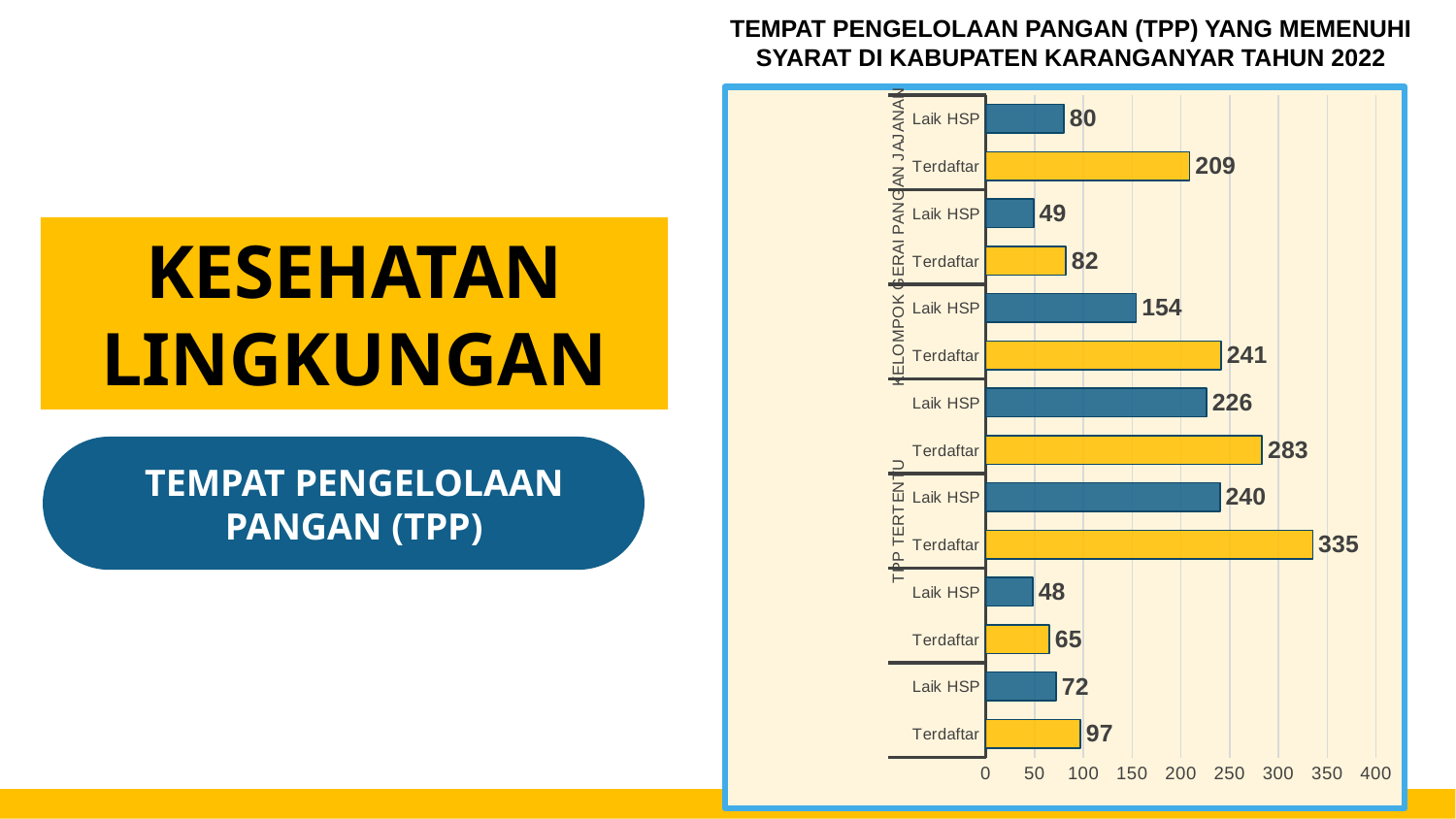
What is the highest value shown on any bar in the chart? 335 Which is larger: the bottom-most Terdaftar bar or the bottom-most Laik HSP bar? Terdaftar What kind of chart is shown on the slide? bar chart What is the difference between the topmost Terdaftar bar (209) and the topmost Laik HSP bar (80)? 129 What is the difference between the largest Terdaftar bar (335) and the Laik HSP bar directly above it (240)? 95 What is the value of the topmost Terdaftar bar in the chart? 209 What is the lowest value shown on any bar in the chart? 48 What is the value of the topmost Laik HSP bar in the chart? 80 What is the value of the bottom-most Laik HSP bar in the chart? 72 What is the value of the bottom-most Terdaftar bar in the chart? 97 What colour are the Laik HSP bars in the chart? blue How many bars are plotted in the chart? 14